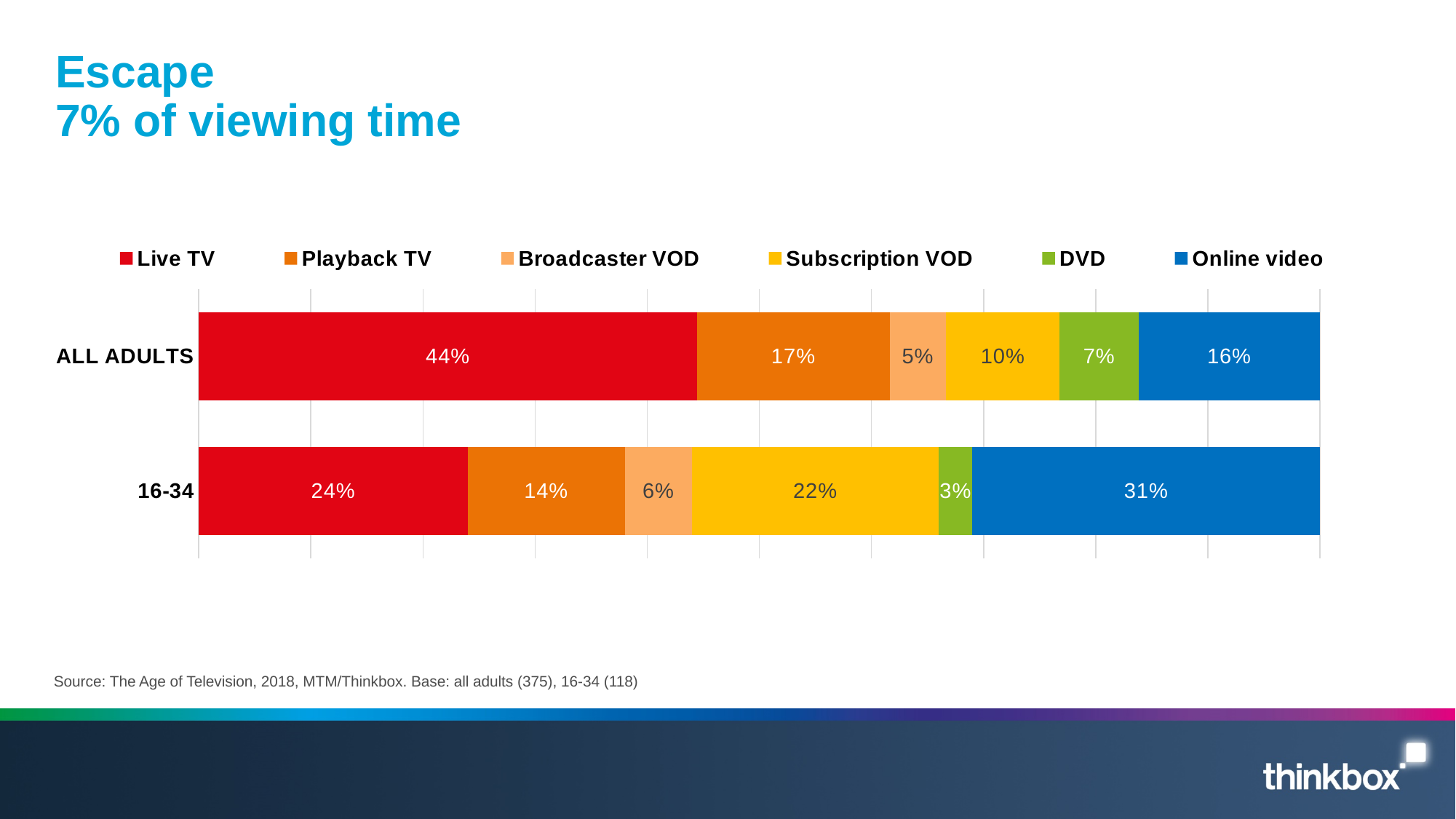
What is the total of the stacked bar for the 16-34 group? 100% Which is larger for the 16-34 group: Online video or Live TV? Online video How many categories (bars) are shown on the chart? 2 What is the DVD value for ALL ADULTS? 7% What share of viewing time is Online video for the 16-34 group? 31% What is the difference between the Live TV share for ALL ADULTS and for 16-34? 20% What share of viewing time is Live TV for ALL ADULTS? 44% How many series does the legend list? 6 What kind of chart is shown on the slide? Stacked bar chart Which series has the largest share for ALL ADULTS? Live TV Which series has the smallest share for the 16-34 group? DVD What is the Subscription VOD value for the 16-34 group? 22%